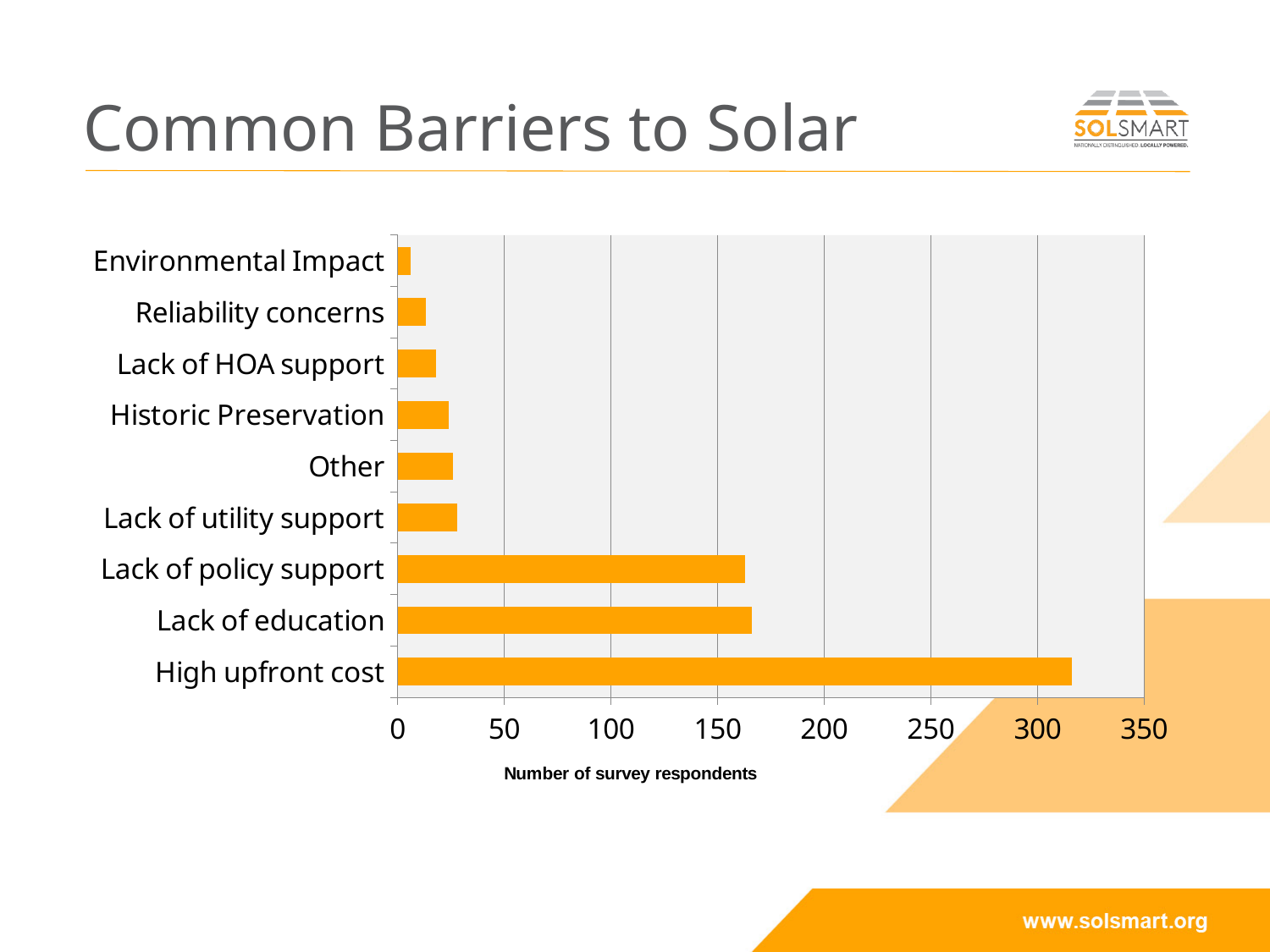
Which barrier has the lowest number of survey respondents? Environmental Impact Which has more survey respondents, Lack of HOA support or High upfront cost? High upfront cost How many barrier categories are plotted in the chart? 9 Is the value for Environmental Impact greater or less than 50? less What is the label of the horizontal axis of the chart? Number of survey respondents Is the value for High upfront cost greater or less than 300? greater Is the value for Lack of policy support greater or less than 200? less Which barrier has the highest number of survey respondents? High upfront cost Which has more survey respondents, Historic Preservation or Reliability concerns? Historic Preservation What kind of chart is shown on the slide? bar chart